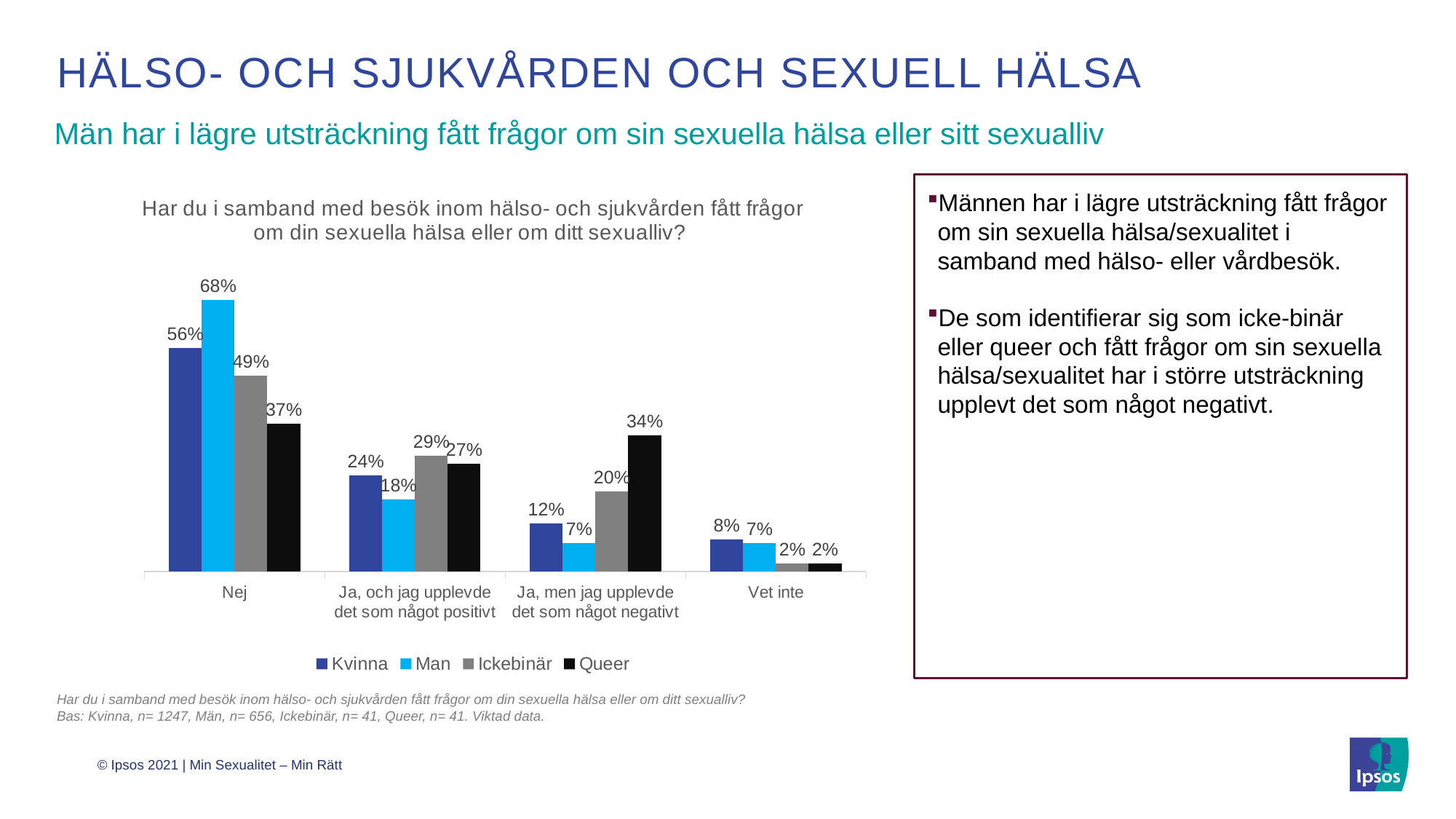
Which colour represents the Queer series in the chart? Black What is the value for Ickebinär in the 'Ja, och jag upplevde det som något positivt' category? 29% Which is larger in the 'Ja, och jag upplevde det som något positivt' category: Kvinna or Man? Kvinna Which series has the highest value in the Nej category? Man How many categories are shown on the x axis? 4 What is the value for Kvinna in the Vet inte category? 8% Which series has the lowest value in the 'Ja, men jag upplevde det som något negativt' category? Man How many series does the legend list? 4 What is the difference between the Man and Queer values in the Nej category? 31 percentage points What kind of chart is shown on the slide? Bar chart What is the value for Queer in the 'Ja, men jag upplevde det som något negativt' category? 34% What is the value for Man in the Nej category? 68%